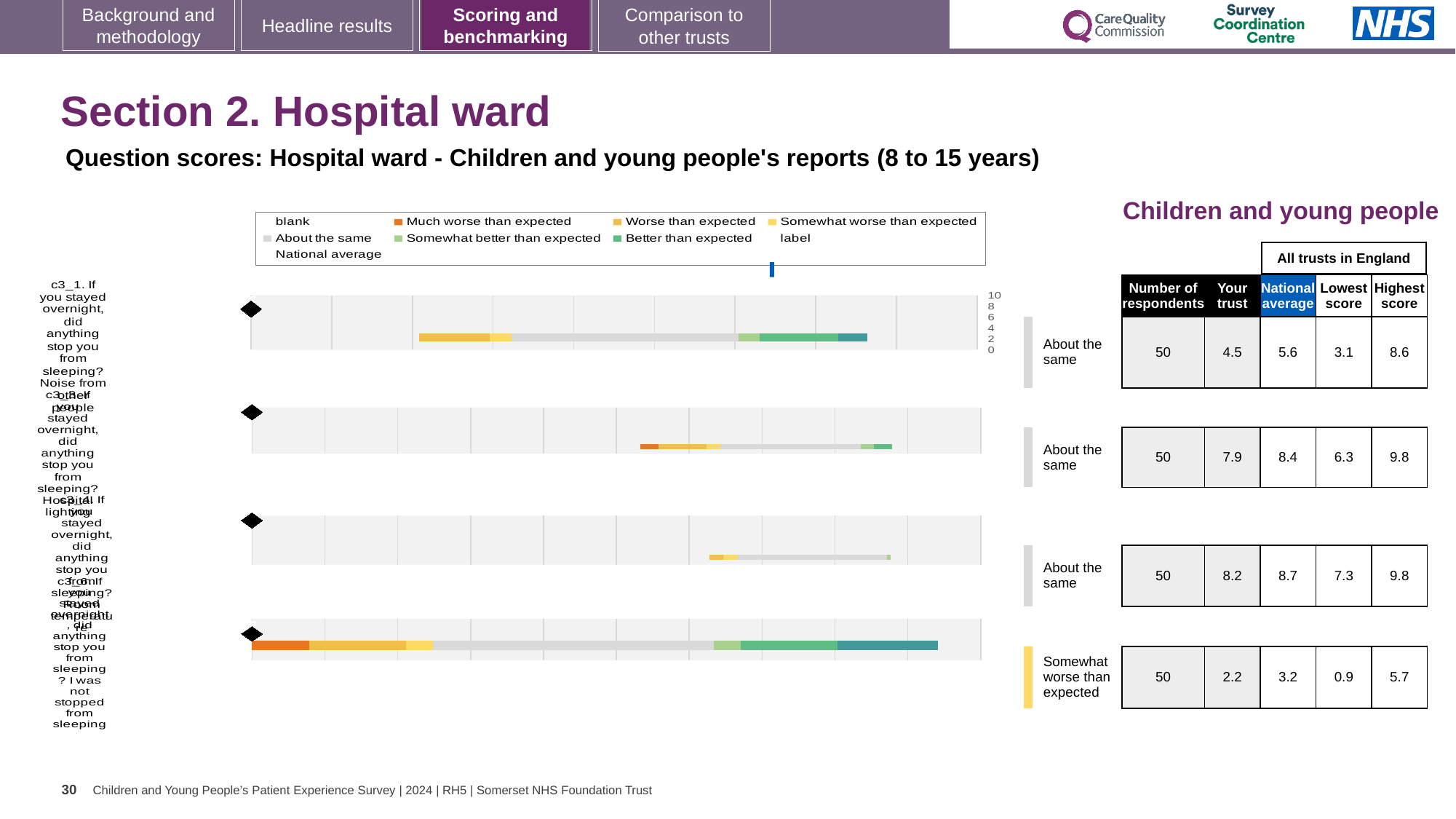
Which row of the table has the highest 'Your trust' score? The third row (8.2) In the table beside the chart, what is the 'Your trust' score for the first row (c3_1, noise from other people)? 4.5 For the first row of the table, which is larger: the 'Your trust' score or the national average? National average In the table beside the chart, what is the highest score for the fourth row (rated 'Somewhat worse than expected')? 5.7 What colour does the legend use for 'Better than expected'? Teal What kind of chart is shown on the slide? Bar chart What colour does the legend use for 'Much worse than expected'? Orange How many entries does the chart legend list? 9 How many respondents are listed for each question in the table? 50 How many horizontal bars are plotted in the chart? 4 In the table beside the chart, what is the national average for the first row (c3_1, noise from other people)? 5.6 For the first row of the table, what is the difference between the national average (5.6) and the 'Your trust' score (4.5)? 1.1